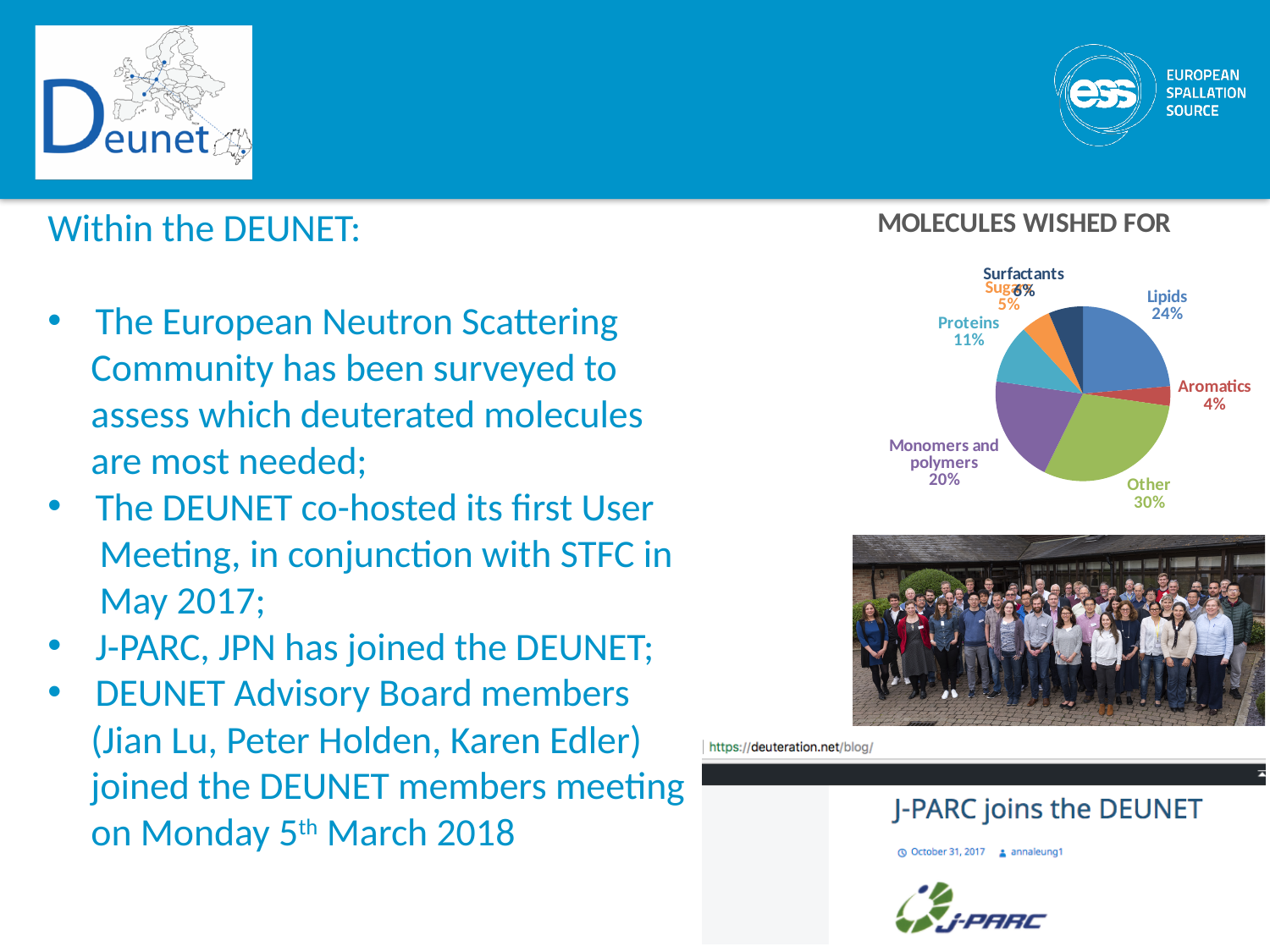
In the 'MOLECULES WISHED FOR' pie chart, what percentage is shown for Lipids? 24% Which category has the smallest slice in the 'MOLECULES WISHED FOR' pie chart? Aromatics In the 'MOLECULES WISHED FOR' pie chart, what percentage is shown for Other? 30% What type of chart is shown under the title 'MOLECULES WISHED FOR'? pie chart Which category has the largest slice in the 'MOLECULES WISHED FOR' pie chart? Other How many slices does the 'MOLECULES WISHED FOR' pie chart have? 7 In the 'MOLECULES WISHED FOR' pie chart, what percentage is shown for Aromatics? 4% In the 'MOLECULES WISHED FOR' pie chart, what percentage is shown for Proteins? 11% In the 'MOLECULES WISHED FOR' pie chart, what percentage is shown for Monomers and polymers? 20% In the 'MOLECULES WISHED FOR' pie chart, what is the difference in percentage points between Other and Lipids? 6 What is the title of the pie chart on the slide? MOLECULES WISHED FOR In the 'MOLECULES WISHED FOR' pie chart, which is larger: Lipids or Monomers and polymers? Lipids